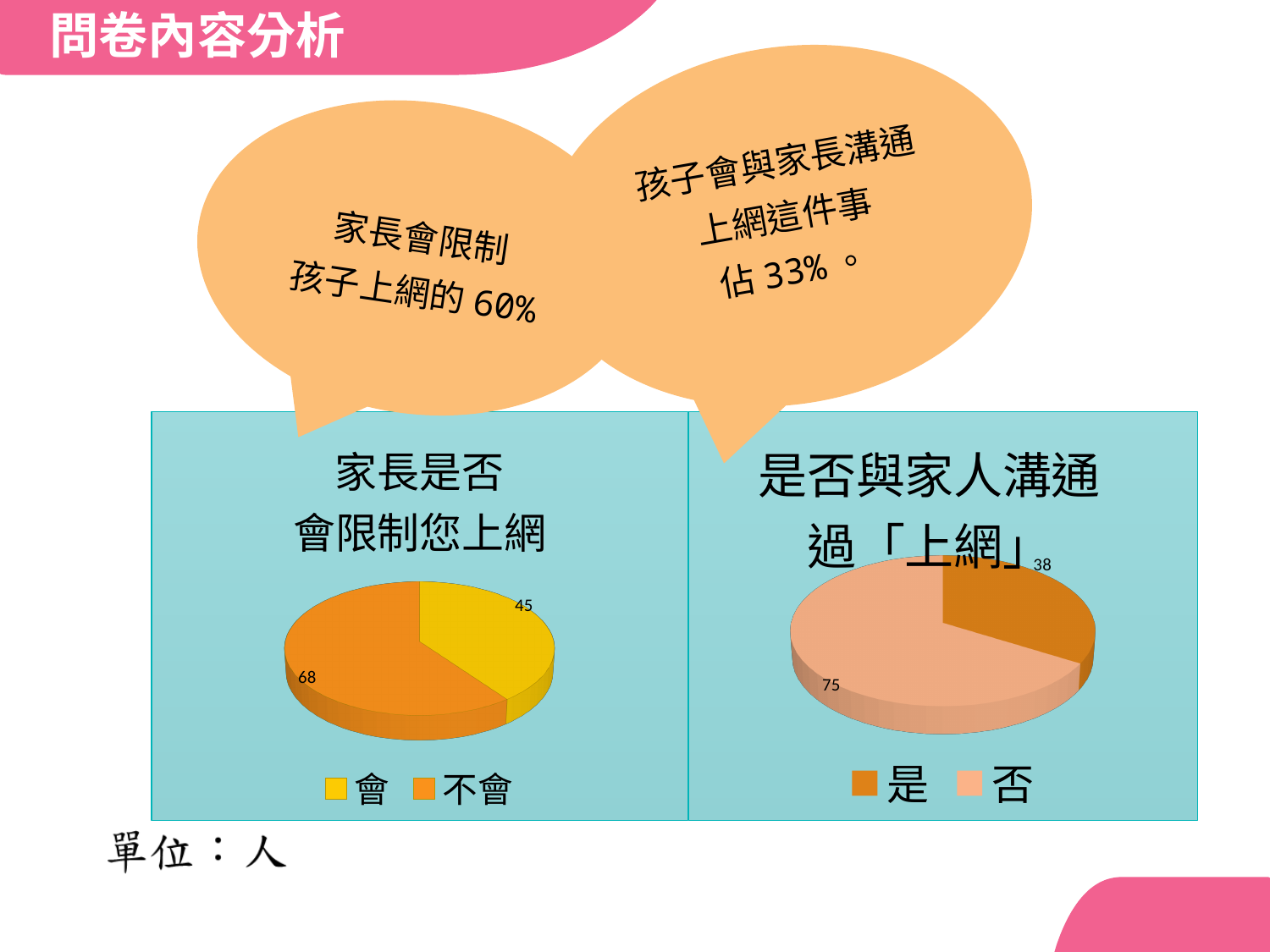
In the left chart titled 家長是否會限制您上網, what is the difference between 不會 and 會? 23 In the right chart titled 是否與家人溝通過「上網」, is the value for 否 larger than the value for 是? Yes In the right chart titled 是否與家人溝通過「上網」, what is the value for 是? 38 In the right chart titled 是否與家人溝通過「上網」, what is the difference between 否 and 是? 37 In the right chart titled 是否與家人溝通過「上網」, what is the value for 否? 75 In the left chart titled 家長是否會限制您上網, which category has the larger value? 不會 What kind of chart is the left chart titled 家長是否會限制您上網? Pie chart According to the text below the charts, what unit are the values in? 人 In the left chart titled 家長是否會限制您上網, what is the value for 會? 45 In the left chart titled 家長是否會限制您上網, what is the value for 不會? 68 How many categories does the legend of the right chart titled 是否與家人溝通過「上網」 list? 2 In the right chart titled 是否與家人溝通過「上網」, which category has the smaller value? 是